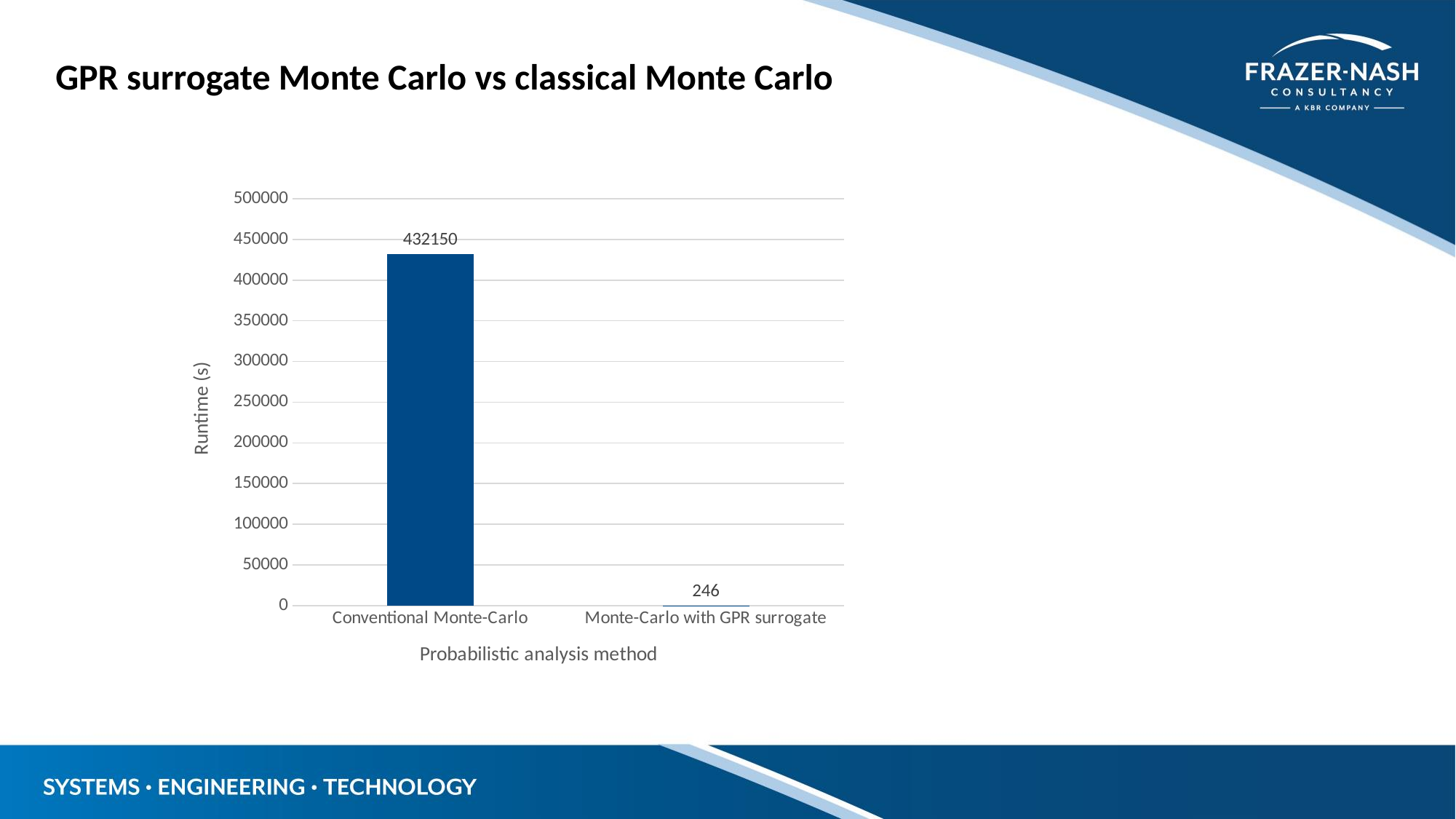
Is the runtime for Conventional Monte-Carlo greater or less than 400000? greater What is the difference in runtime between Conventional Monte-Carlo and Monte-Carlo with GPR surrogate? 431904 Which probabilistic analysis method has the highest runtime? Conventional Monte-Carlo What is the runtime for Conventional Monte-Carlo? 432150 What is the label of the x axis? Probabilistic analysis method Is the runtime for Monte-Carlo with GPR surrogate greater or less than 50000? less How many probabilistic analysis methods are shown on the chart? 2 What is the runtime for Monte-Carlo with GPR surrogate? 246 What is the label of the y axis? Runtime (s) Which has a larger runtime, Conventional Monte-Carlo or Monte-Carlo with GPR surrogate? Conventional Monte-Carlo What kind of chart is shown on the slide? bar chart Which probabilistic analysis method has the lowest runtime? Monte-Carlo with GPR surrogate